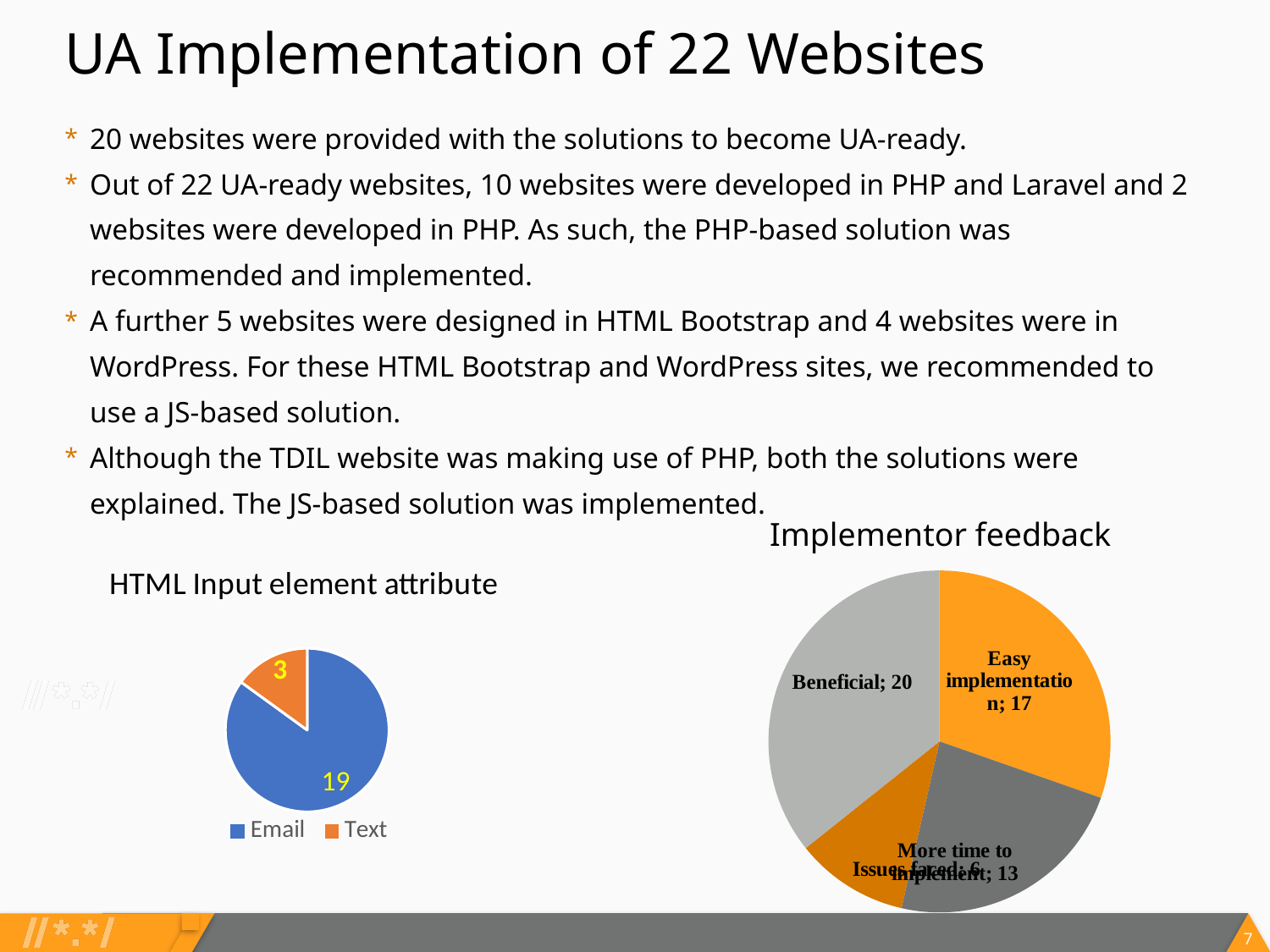
In the 'Implementor feedback' chart, what is the total of all slice values? 56 In the 'HTML Input element attribute' chart, what is the difference between the Email and Text values? 16 In the 'Implementor feedback' chart, what is the value for Easy implementation? 17 In the 'HTML Input element attribute' chart, how many categories does the legend list? 2 In the 'Implementor feedback' chart, which category has the smallest value? Issues faced In the 'Implementor feedback' chart, what is the value for More time to implement? 13 In the 'HTML Input element attribute' chart, what is the value for Email? 19 In the 'Implementor feedback' chart, how many slices are there? 4 In the 'Implementor feedback' chart, which category has the largest value? Beneficial In the 'Implementor feedback' chart, what is the value for Beneficial? 20 In the 'HTML Input element attribute' chart, what is the value for Text? 3 What kind of chart is the 'HTML Input element attribute' chart? Pie chart